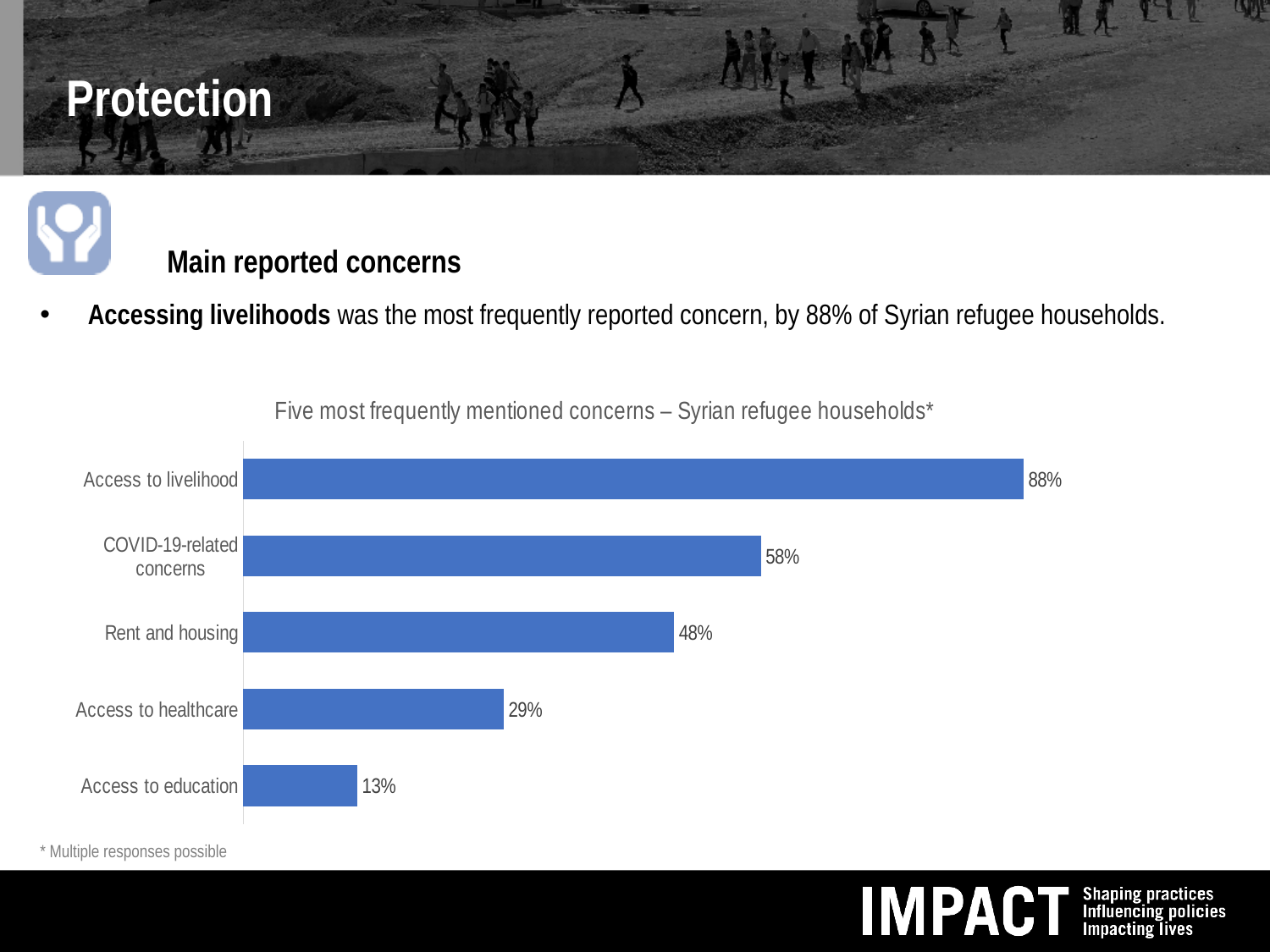
What is the value shown for Access to healthcare? 29% Which concern has the lowest value in the chart? Access to education How many concerns are shown in the chart? 5 Which is larger, the value for Rent and housing or the value for Access to healthcare? Rent and housing What is the value shown for COVID-19-related concerns? 58% What is the title of the chart? Five most frequently mentioned concerns – Syrian refugee households* What percentage of Syrian refugee households reported Access to livelihood as a concern? 88% What type of chart is shown on the slide? Bar chart Which concern has the highest value in the chart? Access to livelihood What is the difference between the values for Access to livelihood and COVID-19-related concerns? 30% What is the difference between the values for Access to healthcare and Access to education? 16% What is the value shown for Rent and housing? 48%